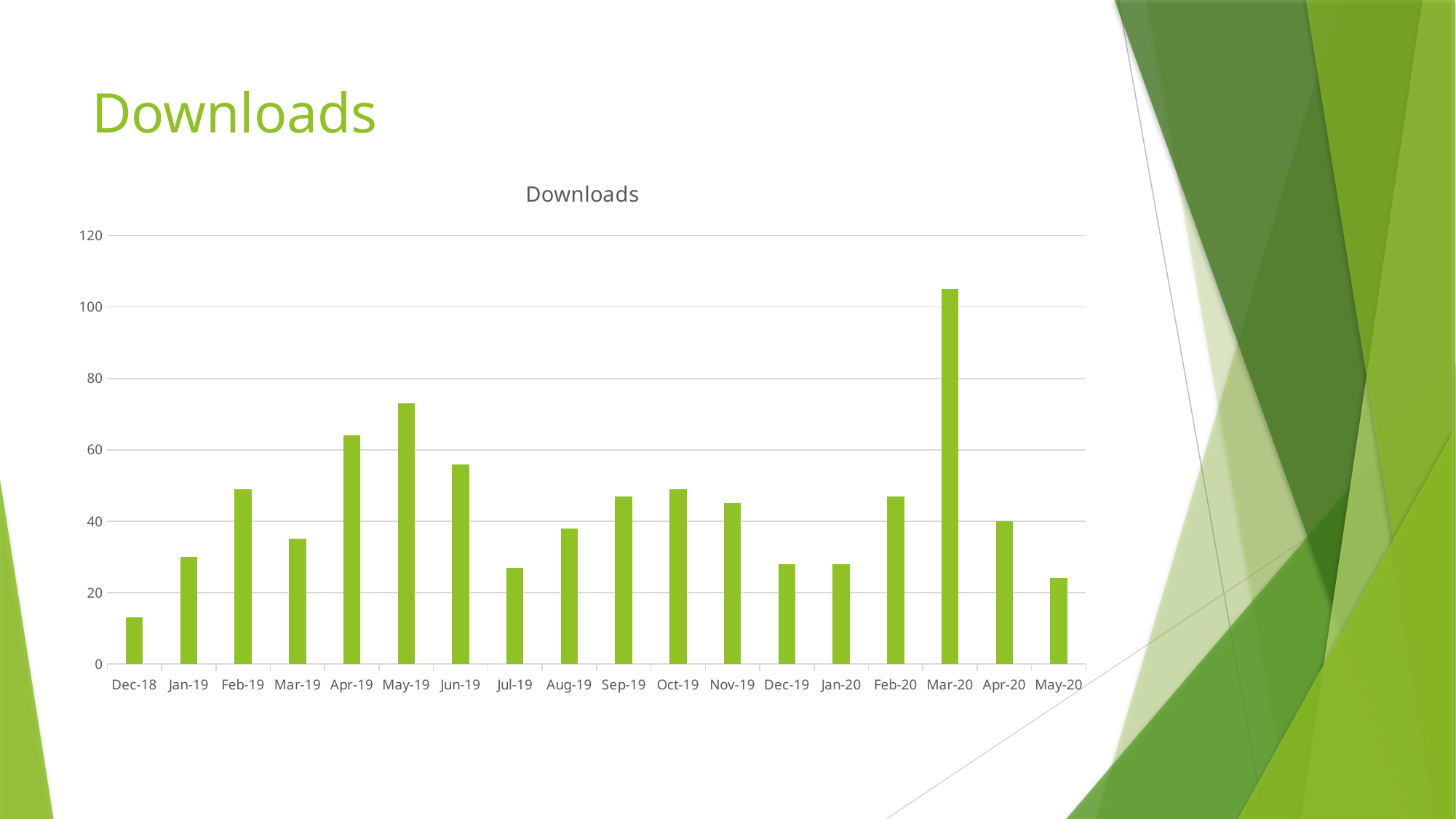
Is the value for Dec-18 greater or less than 20? less What type of chart is shown on the slide? bar chart Which month has the highest number of downloads? Mar-20 Is the value for Mar-20 greater or less than 100? greater Which month has more downloads, Jan-19 or Mar-19? Mar-19 Is the value for May-19 greater or less than 60? greater How many months are shown on the x axis of the chart? 18 Which month has the lowest number of downloads? Dec-18 Which month has more downloads, Apr-19 or Jun-19? Apr-19 What is the title of the chart? Downloads